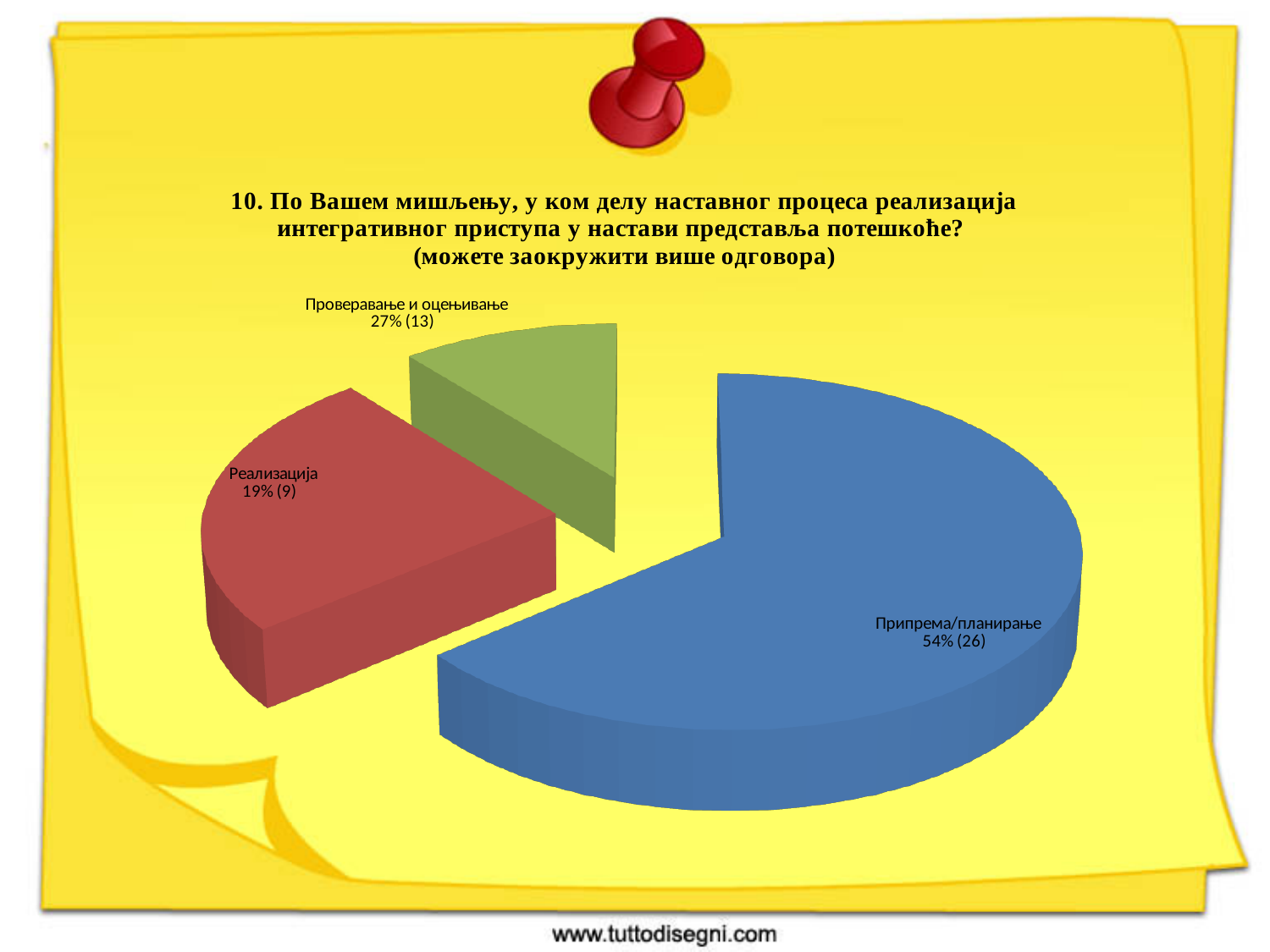
What percentage is shown for Припрема/планирање? 54% What is the difference in responses between Припрема/планирање and Реализација? 17 How many slices does the pie chart have? 3 How many responses are shown for Проверавање и оцењивање? 13 Which category has the largest share of the pie? Припрема/планирање What is the total number of responses across all three slices? 48 How many responses are shown for Припрема/планирање? 26 What percentage is shown for Реализација? 19% What colour is the slice for Припрема/планирање? blue What kind of chart is shown on the slide? pie chart